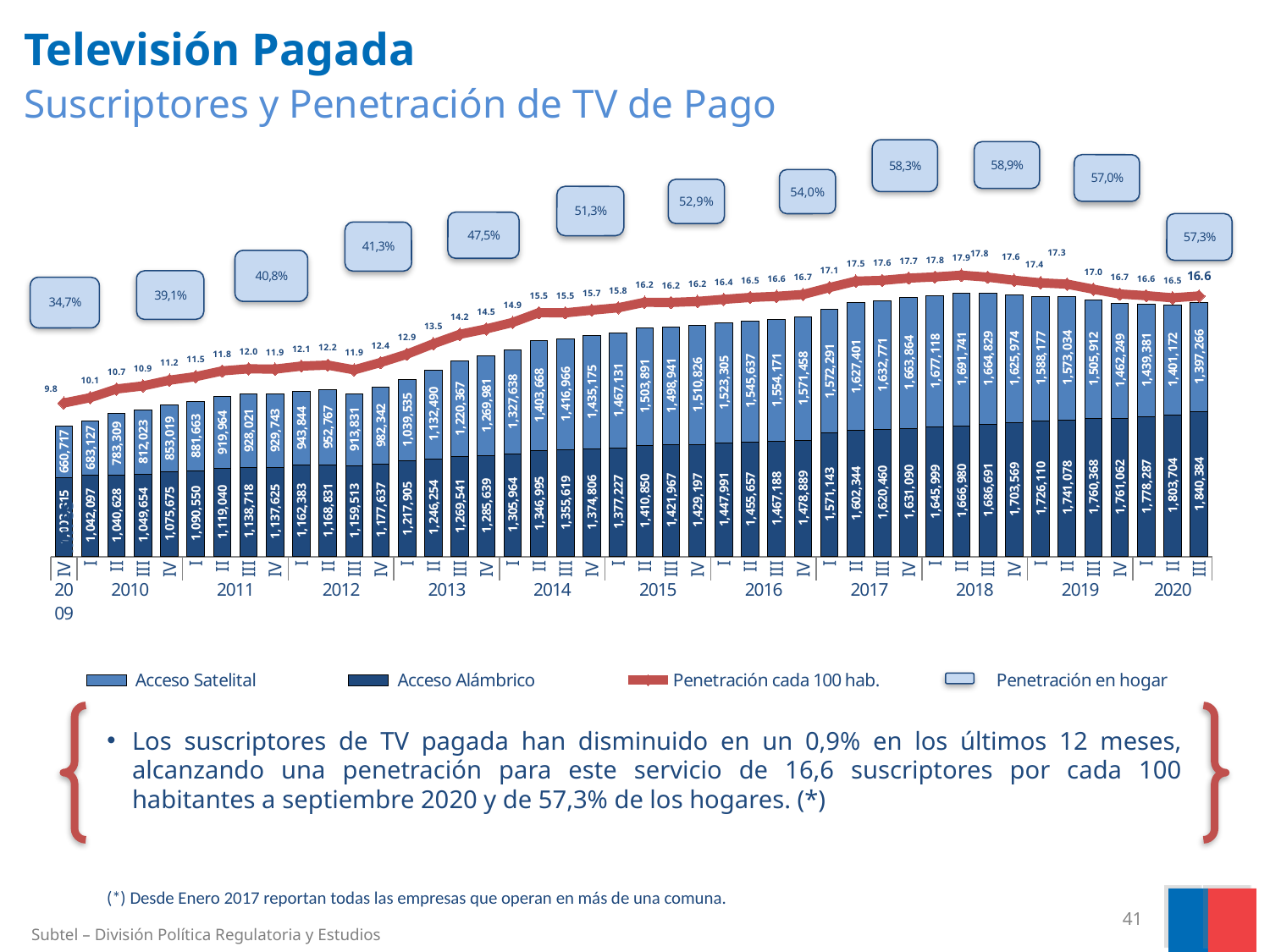
What is the difference between Acceso Alámbrico and Acceso Satelital in the third quarter (III) of 2020? 443,118 What is the highest Penetración en hogar value shown on the chart? 58,9% Does the Penetración cada 100 hab. line rise or fall from the fourth quarter of 2009 to the first quarter of 2018? Rise What is the value of Acceso Alámbrico in the third quarter (III) of 2020? 1,840,384 What is the total of the stacked bar (Acceso Satelital plus Acceso Alámbrico) for the third quarter (III) of 2020? 3,237,650 What is the Penetración cada 100 hab. value for the third quarter (III) of 2020? 16.6 What is the Penetración en hogar value shown for the third quarter (III) of 2020? 57,3% In the third quarter (III) of 2020, which is larger: Acceso Satelital or Acceso Alámbrico? Acceso Alámbrico What kind of chart is shown on the slide? Stacked bar chart with a line How many series does the legend list? 4 What is the lowest Penetración cada 100 hab. value shown on the chart? 9.8 What is the value of Acceso Satelital in the third quarter (III) of 2020? 1,397,266